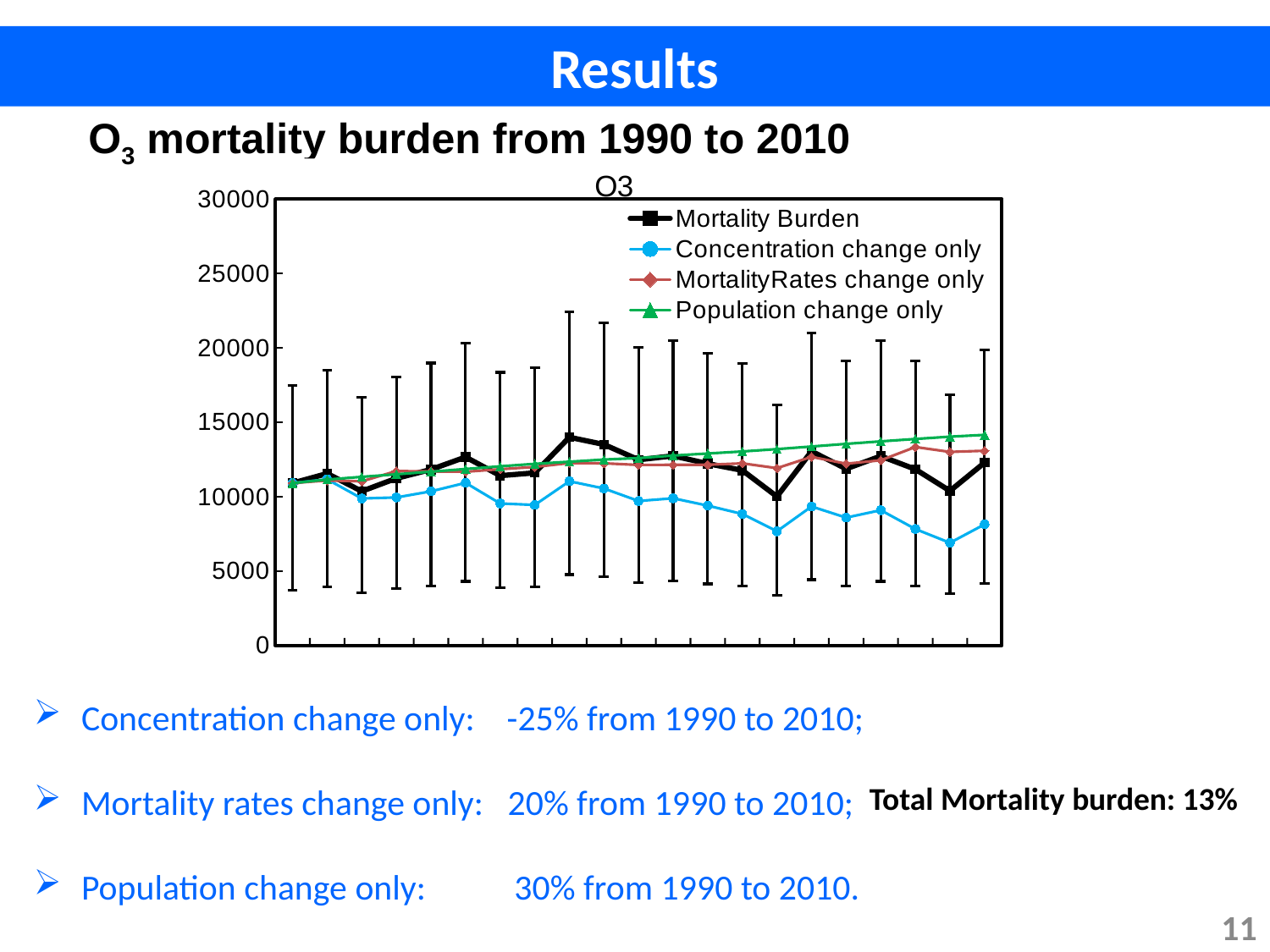
Which series has the lowest value at the rightmost point of the chart? Concentration change only How many data points does each series have along the x axis? 21 Does the 'Population change only' series rise or fall from left to right along the x axis? rise At the rightmost point, which is larger: 'Population change only' or 'Concentration change only'? Population change only How many series does the chart legend list? 4 Which series in the legend is drawn in black with square markers? Mortality Burden What kind of chart is shown on the slide? line chart Which series has the highest value at the rightmost point of the chart? Population change only What is the title printed above the chart? O3 Does the 'Concentration change only' series rise or fall overall from left to right along the x axis? fall Is the value of 'Concentration change only' at the rightmost point greater or less than 10000? less Is the highest value of the 'Mortality Burden' series greater or less than 10000? greater